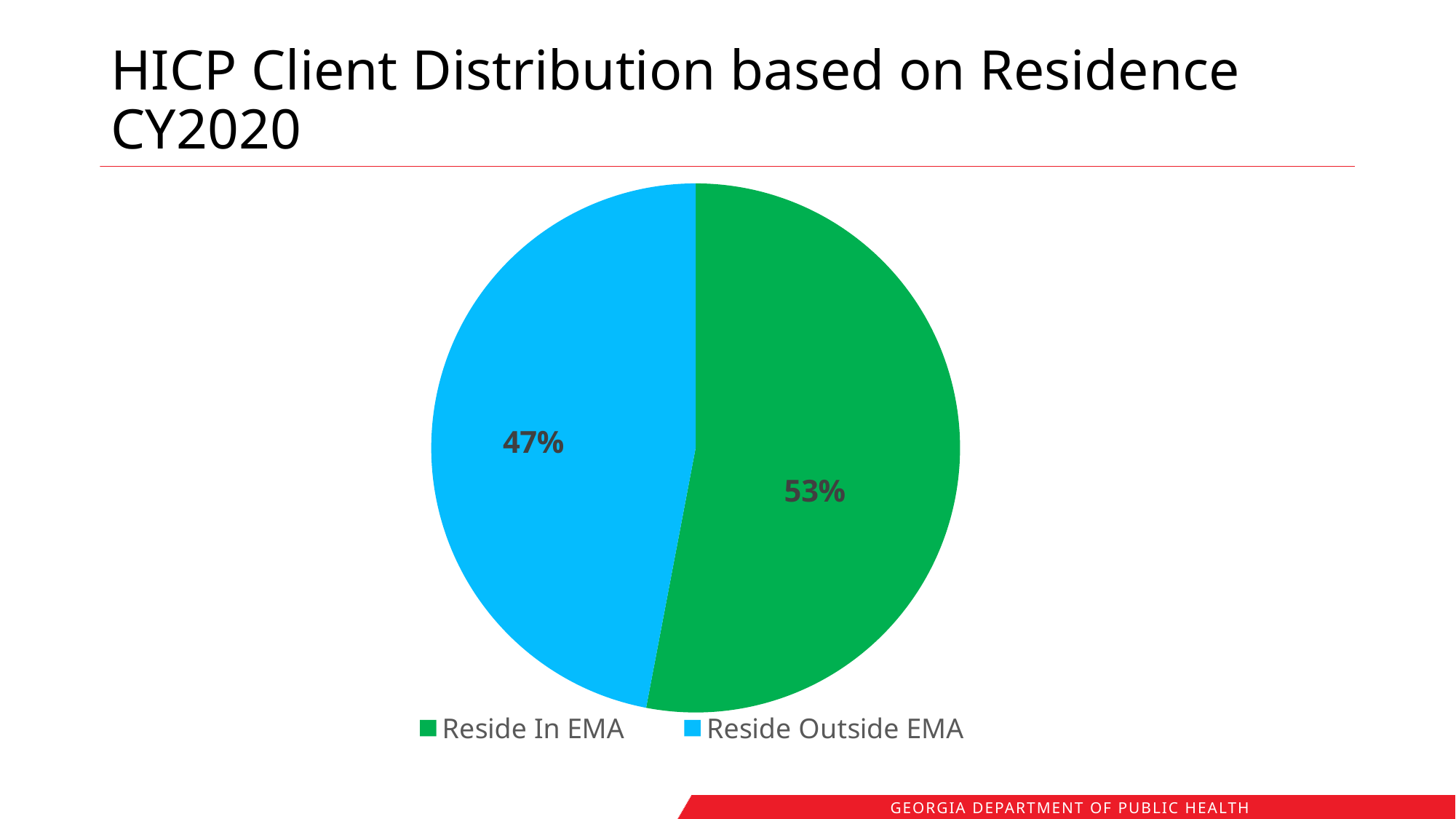
Which category has the larger share of the pie? Reside In EMA What percentage of HICP clients reside outside the EMA? 47% Is the share for Reside In EMA larger or smaller than the share for Reside Outside EMA? Larger What is the difference in percentage points between clients residing in the EMA and those residing outside the EMA? 6 What type of chart is shown on the slide? Pie chart What colour represents the Reside Outside EMA slice? Blue How many entries does the legend list? 2 Which category has the smaller share of the pie? Reside Outside EMA What is the title of the slide containing the chart? HICP Client Distribution based on Residence CY2020 How many categories does the pie chart show? 2 What percentage of HICP clients reside in the EMA? 53% Is the share for Reside In EMA greater or less than 50%? greater